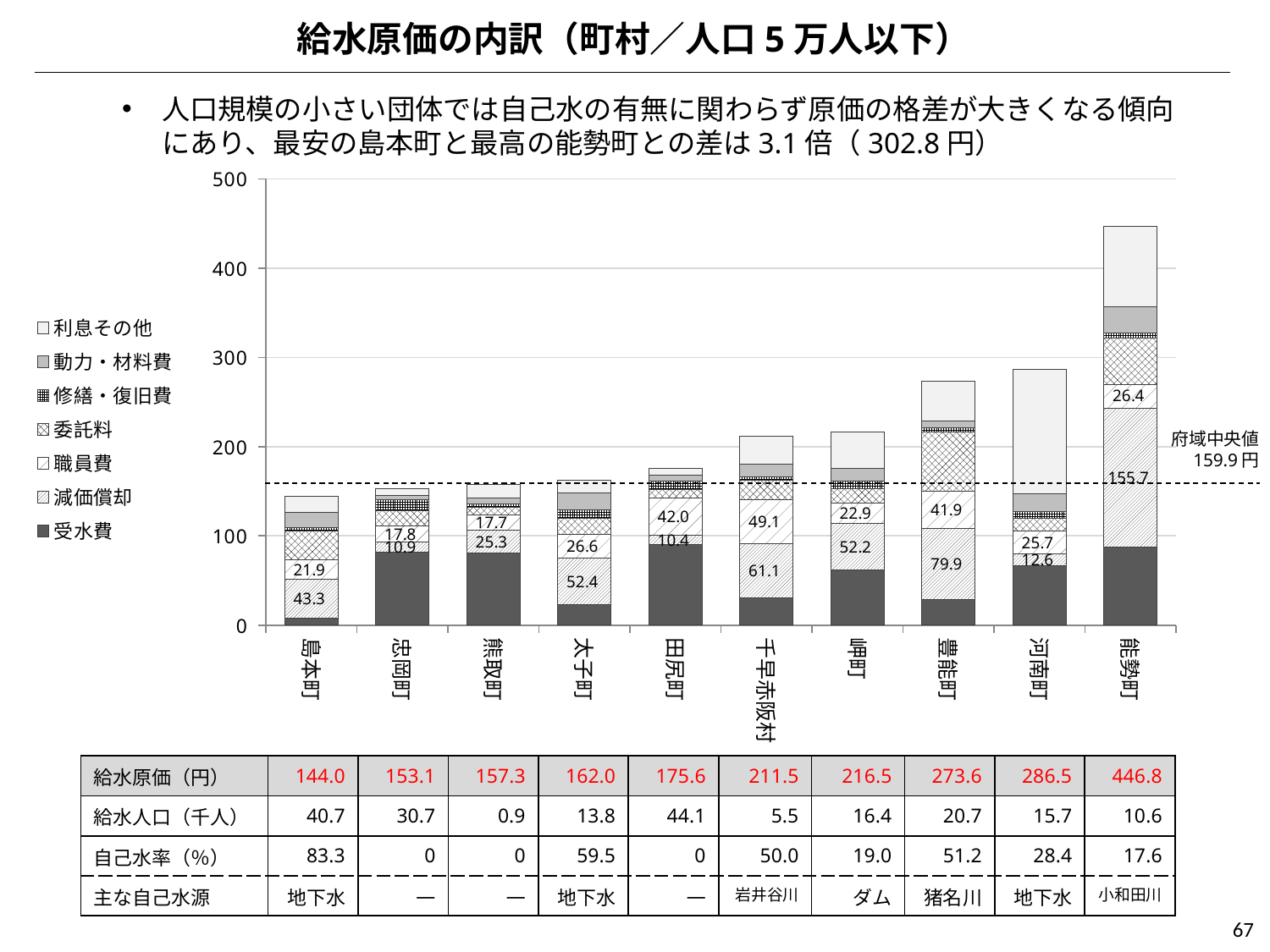
How many series does the chart's legend list? 7 What kind of chart is shown on the slide? Stacked bar chart How many municipalities (bars) are plotted on the chart? 10 According to the 給水原価（円） row beneath the chart, what is the value for 能勢町? 446.8 What is the difference in 給水原価 between 能勢町 (446.8) and 島本町 (144.0)? 302.8 Which municipality has the lowest total 給水原価 bar? 島本町 Which has the larger total 給水原価 bar, 田尻町 or 岬町? 岬町 What value is given for the dashed 府域中央値 line on the chart? 159.9円 Do the total bar heights rise or fall from left to right across the chart? rise Which municipality has the highest total 給水原価 bar? 能勢町 Is the total bar for 河南町 greater or less than 200? greater According to the 給水原価（円） row beneath the chart, what is the value for 豊能町? 273.6